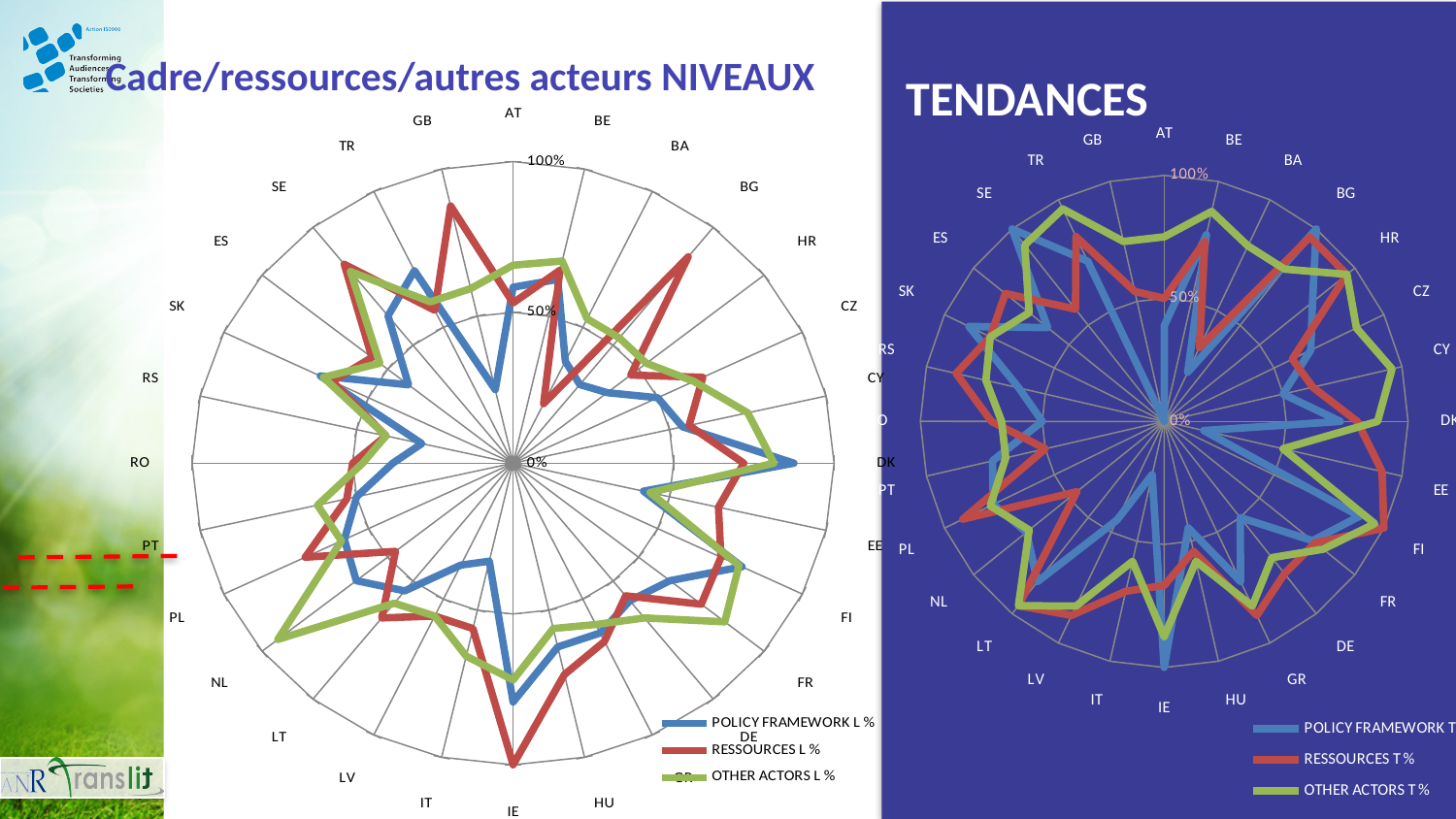
In the right chart (TENDANCES), is the OTHER ACTORS T % value for SE greater or less than 50%? greater How many series does the legend of the right chart (TENDANCES) list? 3 How many series does the legend of the left chart (NIVEAUX) list? 3 In the left chart (NIVEAUX), is the RESSOURCES L % value for IE greater or less than 50%? greater In the right chart (TENDANCES), is the RESSOURCES T % value for HR greater or less than 50%? greater What kind of chart is the left chart titled "Cadre/ressources/autres acteurs NIVEAUX"? Radar chart What kind of chart is the right chart titled "TENDANCES"? Radar chart Which series in the left chart (NIVEAUX) is drawn in green? OTHER ACTORS L %